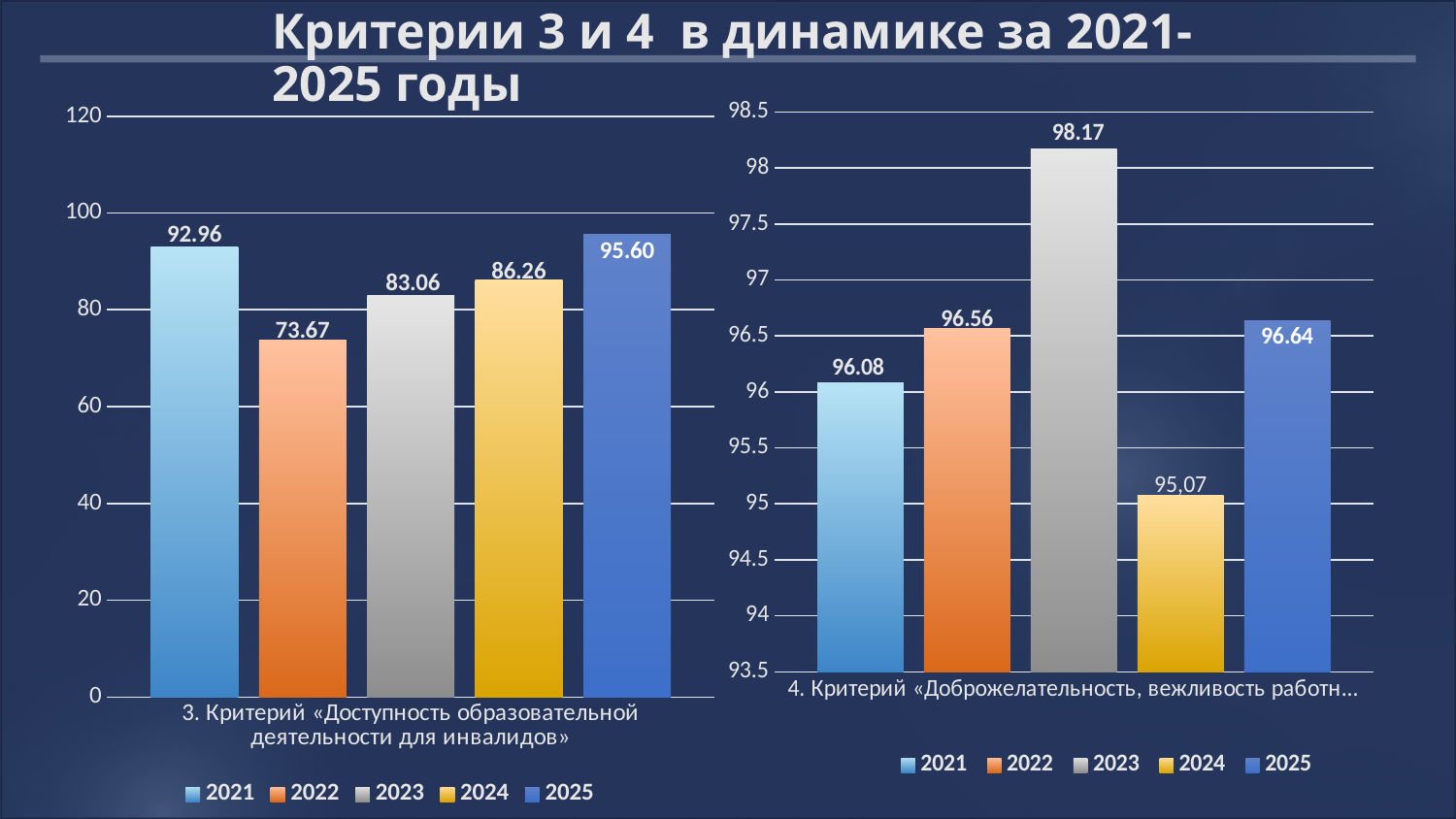
In the right chart (Criterion 4), which year has the lowest value? 2024 In the left chart (Criterion 3), what is the value for 2022? 73.67 In the right chart (Criterion 4), what is the value for 2024? 95,07 In the left chart (Criterion 3), what is the difference between the 2025 value and the 2021 value? 2.64 In the left chart (Criterion 3), what is the value for 2021? 92.96 In the left chart (Criterion 3), which year has the lowest value? 2022 In the right chart (Criterion 4), what is the value for 2023? 98.17 In the right chart (Criterion 4), is the value for 2021 greater or less than 96.5? less In the left chart (Criterion 3), how many series does the legend list? 5 In the left chart (Criterion 3), which year has the highest value? 2025 What kind of chart is the left chart (Criterion 3)? bar chart In the right chart (Criterion 4), which is larger, the value for 2022 or the value for 2025? 2025